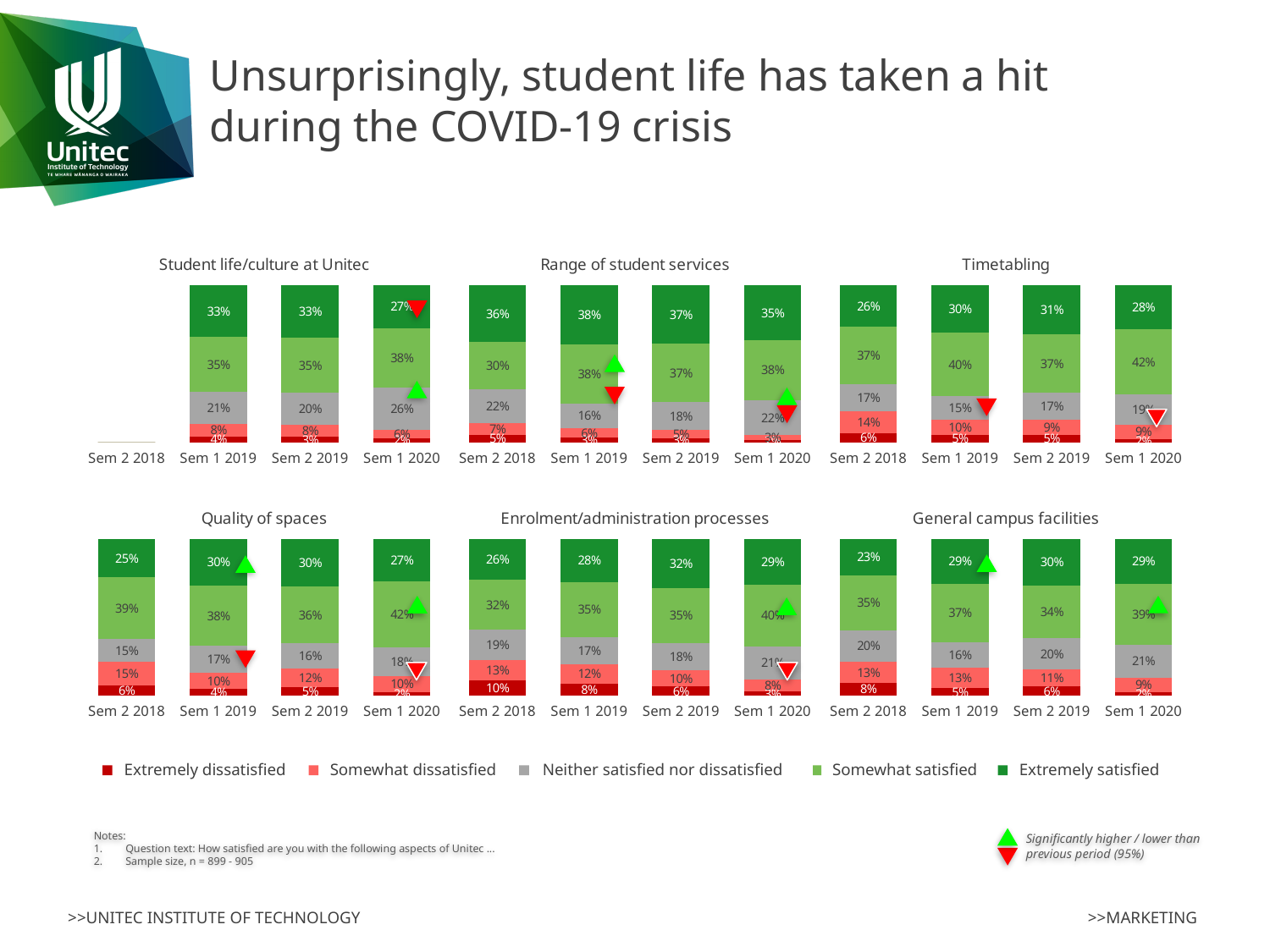
In the 'Enrolment/administration processes' chart, does the extremely dissatisfied percentage rise or fall from Sem 2 2018 to Sem 1 2020? Fall In the 'Timetabling' chart, which period has the lowest somewhat satisfied percentage? Sem 2 2018 and Sem 2 2019 (both 37%) How many series does the legend list? 5 In the 'Timetabling' chart, what percentage were somewhat satisfied in Sem 1 2020? 42% In the 'Student life/culture at Unitec' chart, what percentage of respondents were extremely satisfied in Sem 1 2020? 27% In the 'General campus facilities' chart, which period has the highest extremely satisfied percentage? Sem 2 2019 In the 'Quality of spaces' chart, what percentage were somewhat dissatisfied in Sem 2 2018? 15% What kind of chart is used for 'Range of student services'? Stacked bar chart In the 'Enrolment/administration processes' chart, what is the difference between the somewhat satisfied percentage in Sem 1 2020 and in Sem 2 2018? 8% In the 'Enrolment/administration processes' chart, what percentage were extremely dissatisfied in Sem 2 2018? 10% In the 'Quality of spaces' chart, which is larger: the somewhat satisfied percentage in Sem 1 2020 or in Sem 2 2019? Sem 1 2020 In the 'Range of student services' chart, what percentage were neither satisfied nor dissatisfied in Sem 2 2018? 22%